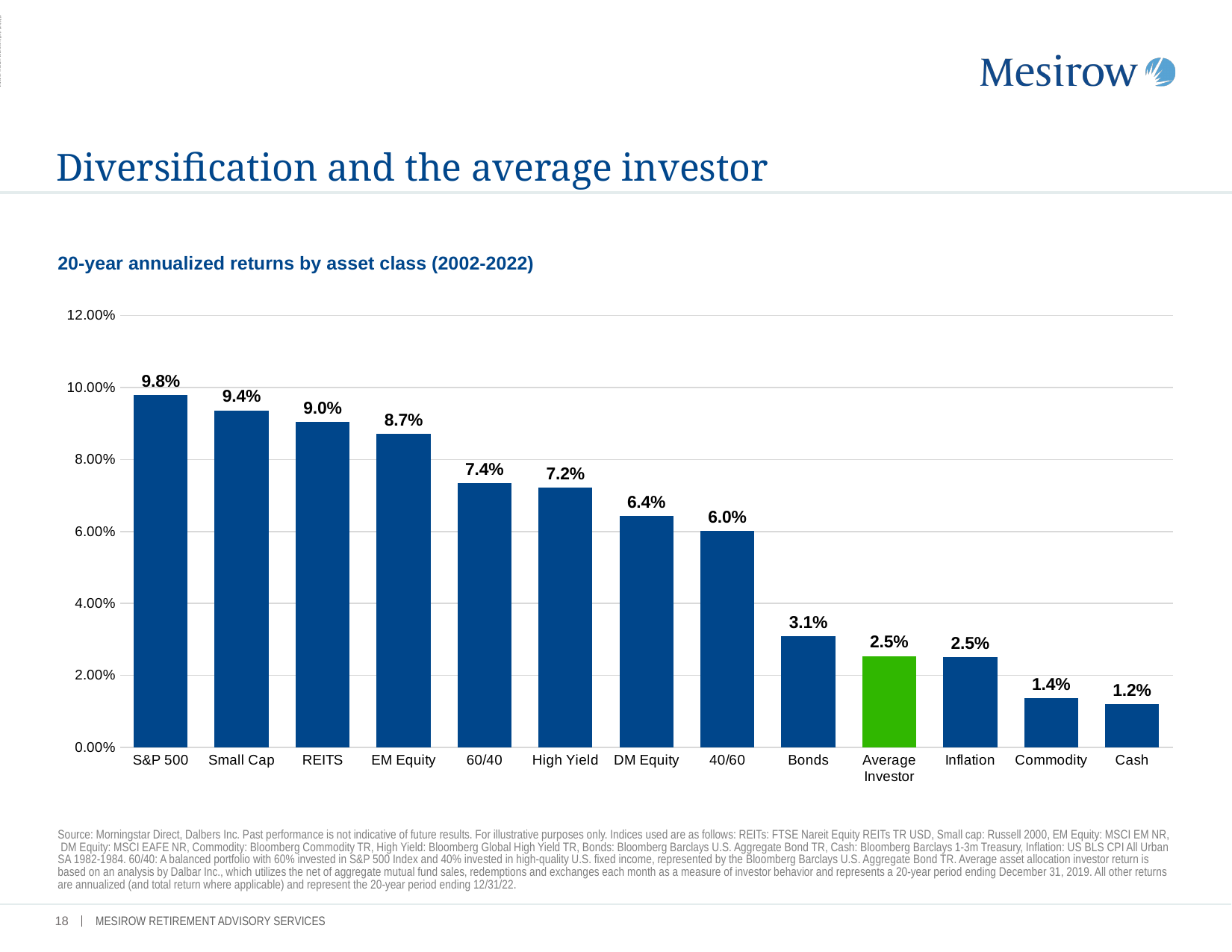
What kind of chart is shown on the slide? Bar chart What is the difference between the S&P 500 return and the Average Investor return? 7.3% What is the 20-year annualized return shown for the S&P 500? 9.8% What is the difference between the 60/40 and 40/60 returns? 1.4% What is the value shown for the Average Investor bar? 2.5% Which category has the lowest value on the chart? Cash Which is larger, the return for REITS or the return for EM Equity? REITS Which bar is coloured green instead of blue? Average Investor Which asset class has the highest 20-year annualized return? S&P 500 Is the value for High Yield greater or less than 8.00%? less What is the value shown for Bonds? 3.1% How many asset classes are shown on the chart? 13